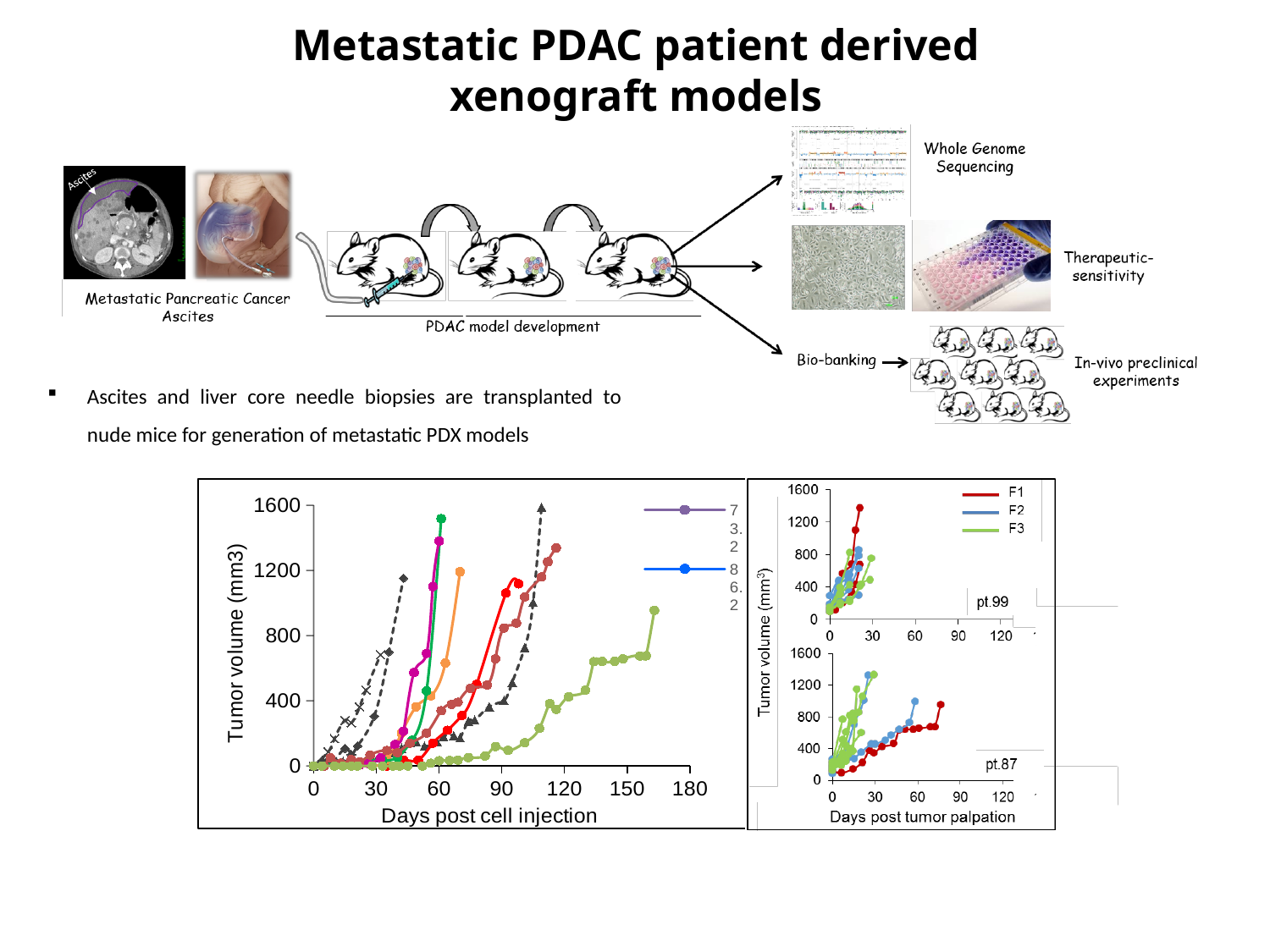
On the left chart, what is the highest value shown on the y axis? 1600 On the left chart, what is the highest value shown on the x axis? 180 On the left chart, is the final value of the light green line (at about 165 days) greater or less than 800? greater In the pt.87 chart on the right, is the peak value of the F1 (red) series greater or less than 1200? less On the left chart, is the peak value of the dark red line (at about 115 days) greater or less than 1200? greater On the left chart, what is the label of the x axis? Days post cell injection On the left chart, do the tumor volumes generally rise or fall as days post cell injection increase? rise In the pt.99 chart on the right, which series reaches the highest tumor volume? F1 How many series does the legend of the pt.99 chart on the right list? 3 On the left chart, what is the label of the y axis? Tumor volume (mm3) What kind of chart is the large chart on the left with the x axis 'Days post cell injection'? line chart